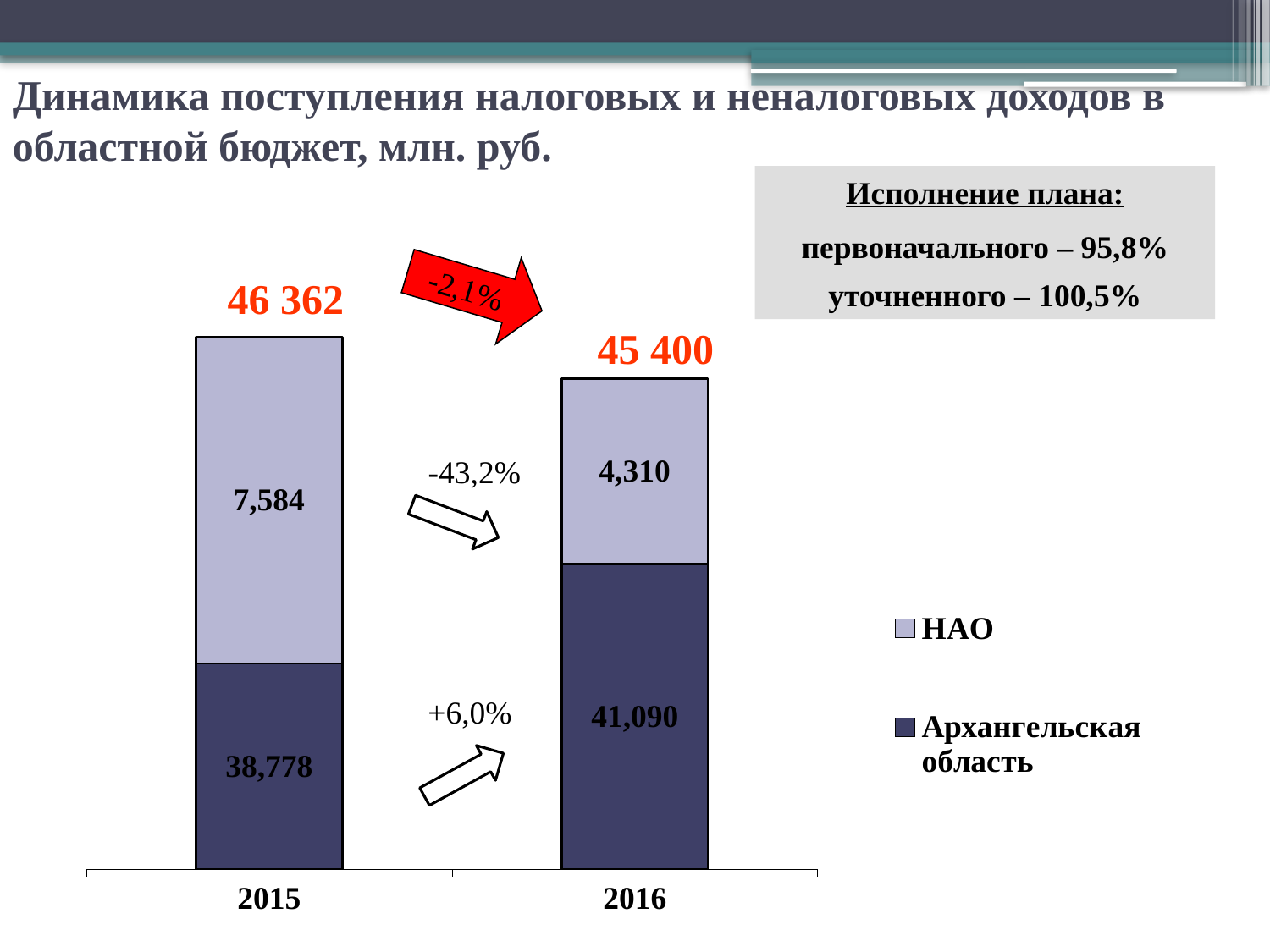
What is the value for Архангельская область in 2016? 41,090 What is the value for НАО in 2016? 4,310 How many categories are shown on the x axis? 2 What is the value for НАО in 2015? 7,584 How many series does the legend list? 2 What is the value for Архангельская область in 2015? 38,778 What is the total shown above the 2015 bar? 46 362 What is the total shown above the 2016 bar? 45 400 What kind of chart is shown on the slide? Stacked bar chart What is the difference between the Архангельская область values for 2016 and 2015? 2,312 Which year has the higher value for Архангельская область, 2015 or 2016? 2016 Which year has the lower value for НАО? 2016